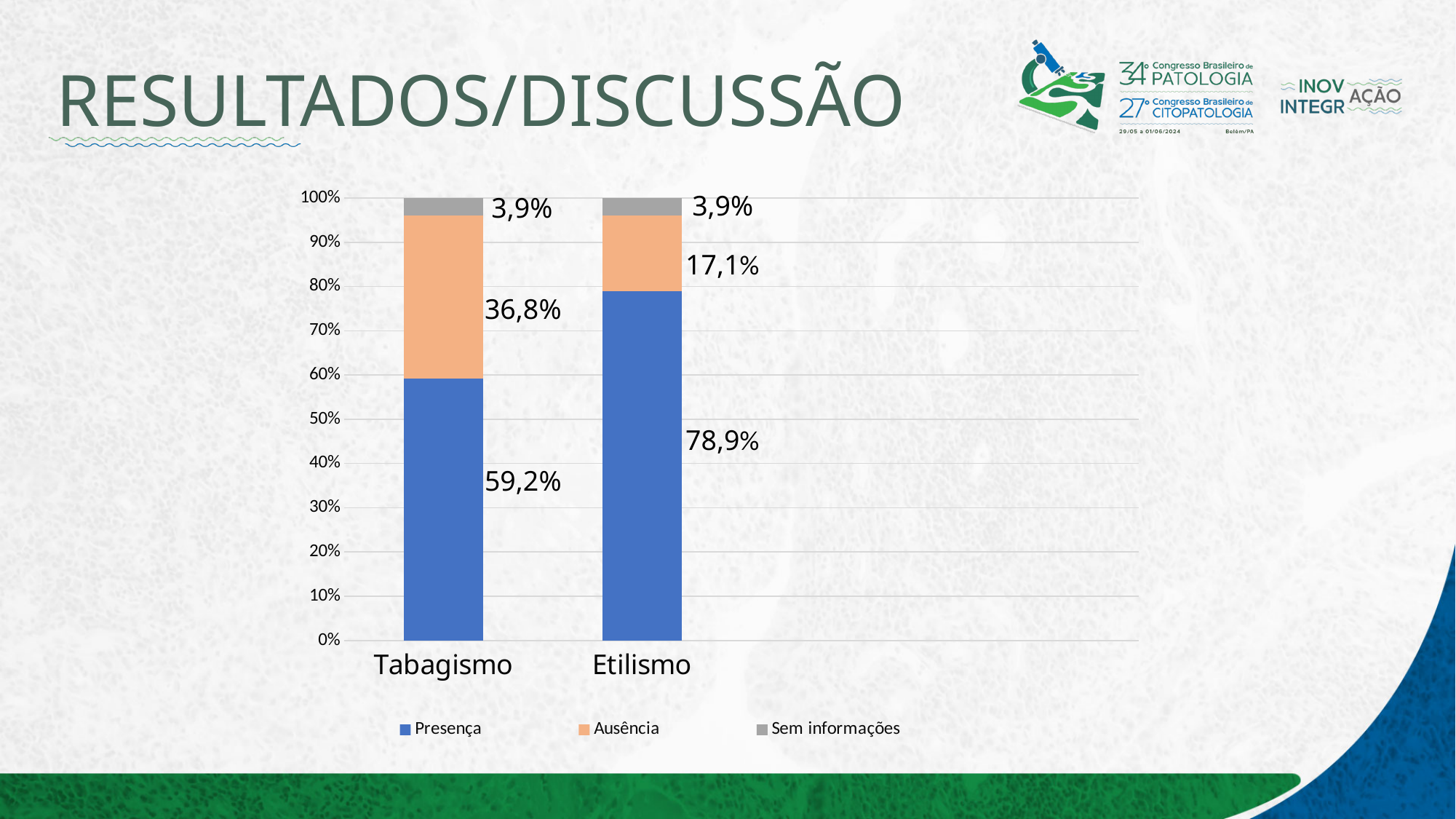
What is the value of Sem informações for Tabagismo? 3,9% What is the value of Presença for Tabagismo? 59,2% How many series does the legend list? 3 What is the difference between the Presença values for Etilismo and Tabagismo? 19,7% What is the value of Presença for Etilismo? 78,9% What is the difference between the Ausência values for Tabagismo and Etilismo? 19,7% What is the value of Ausência for Etilismo? 17,1% Is the Presença value for Tabagismo greater or less than 50%? greater What kind of chart is shown on the slide? Stacked bar chart Which category has the higher Presença value, Tabagismo or Etilismo? Etilismo How many categories are shown on the x axis? 2 Which series is shown in blue? Presença